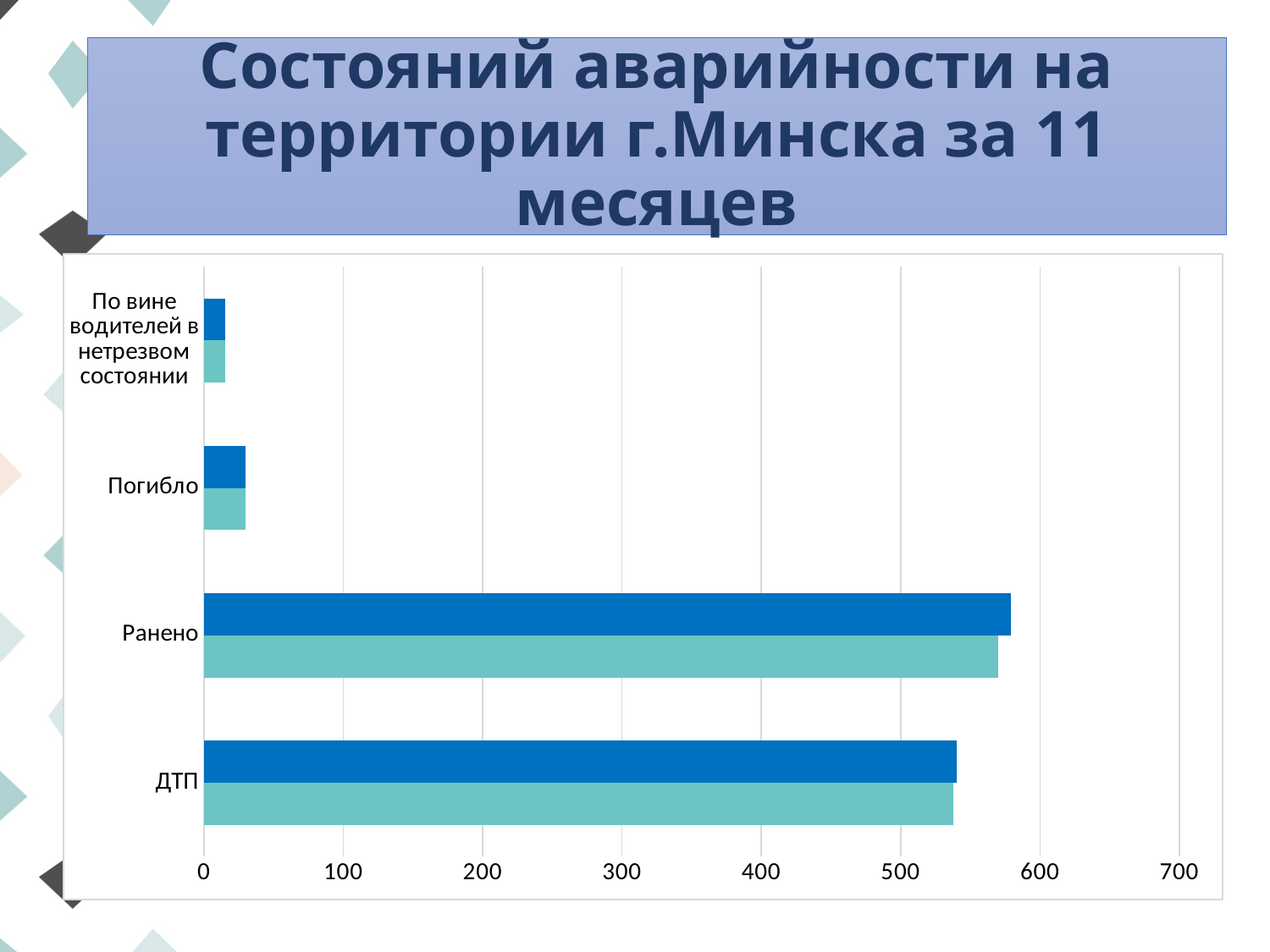
Which has the larger dark blue value, Ранено or ДТП? Ранено Is the dark blue value for По вине водителей в нетрезвом состоянии greater or less than 100? less Which has the larger light teal value, Погибло or По вине водителей в нетрезвом состоянии? Погибло How many categories are shown on the chart? 4 Which category has the longest dark blue bar? Ранено Is the dark blue value for ДТП greater or less than 500? greater Is the dark blue value for Ранено greater or less than 600? less What is the title of the slide? Состояний аварийности на территории г.Минска за 11 месяцев What kind of chart is shown on the slide? bar chart Which category has the longest light teal bar? Ранено Which category has the shortest dark blue bar? По вине водителей в нетрезвом состоянии